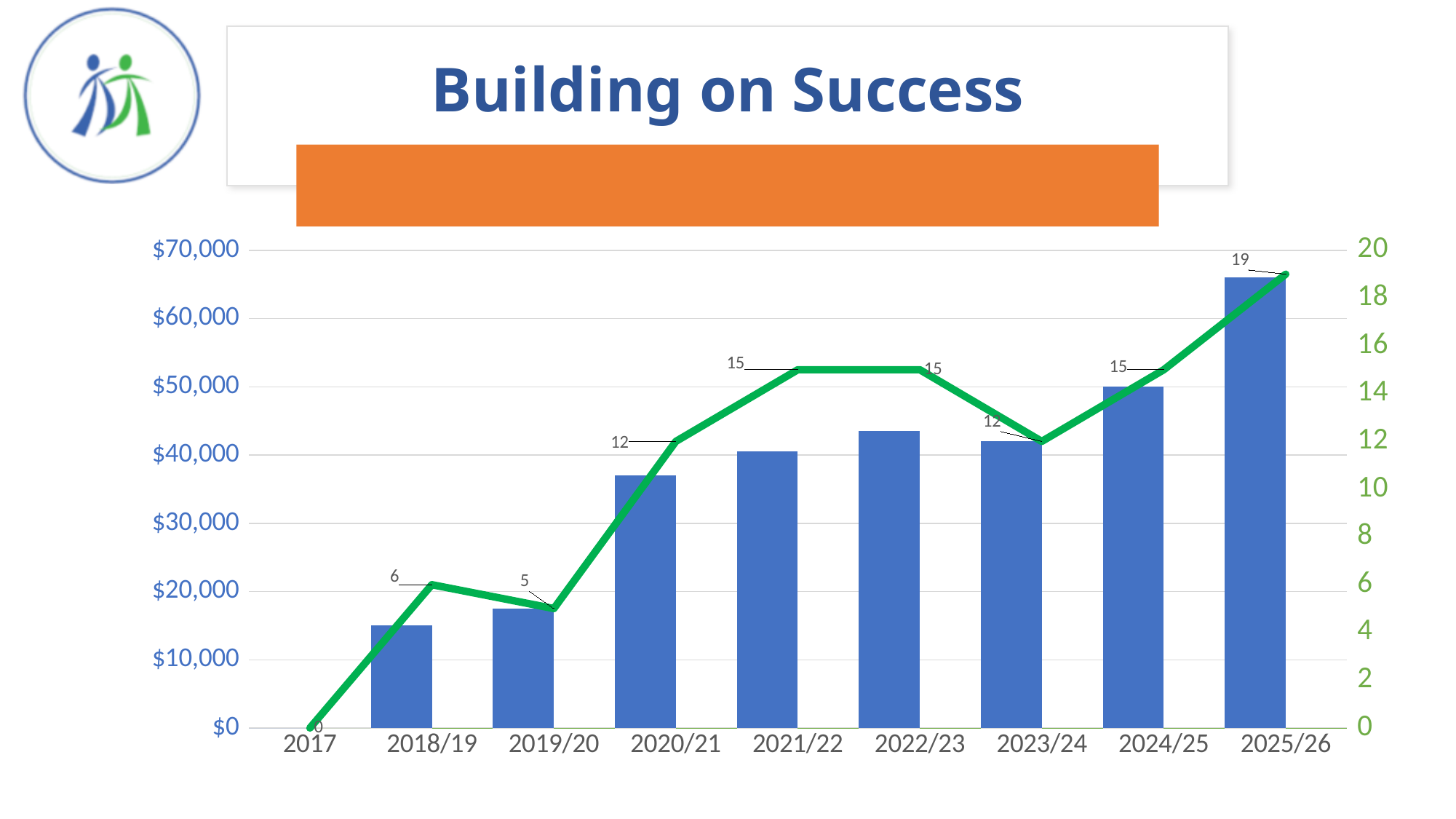
Which has the taller bar, 2023/24 or 2024/25? 2024/25 What is the difference between the green line values for 2018/19 and 2019/20? 1 Is the bar value for 2020/21 greater or less than $30,000? greater By how much does the green line value for 2025/26 exceed the value for 2024/25? 4 What kind of chart is shown on the slide? Combination bar and line chart Is the bar value for 2025/26 greater or less than $60,000? greater What is the value of the green line for 2018/19? 6 How many year categories are shown on the x axis? 9 What is the value of the green line for 2020/21? 12 Is the bar value for 2018/19 greater or less than $20,000? less What is the value of the green line for 2025/26? 19 In which year does the green line reach its highest value? 2025/26